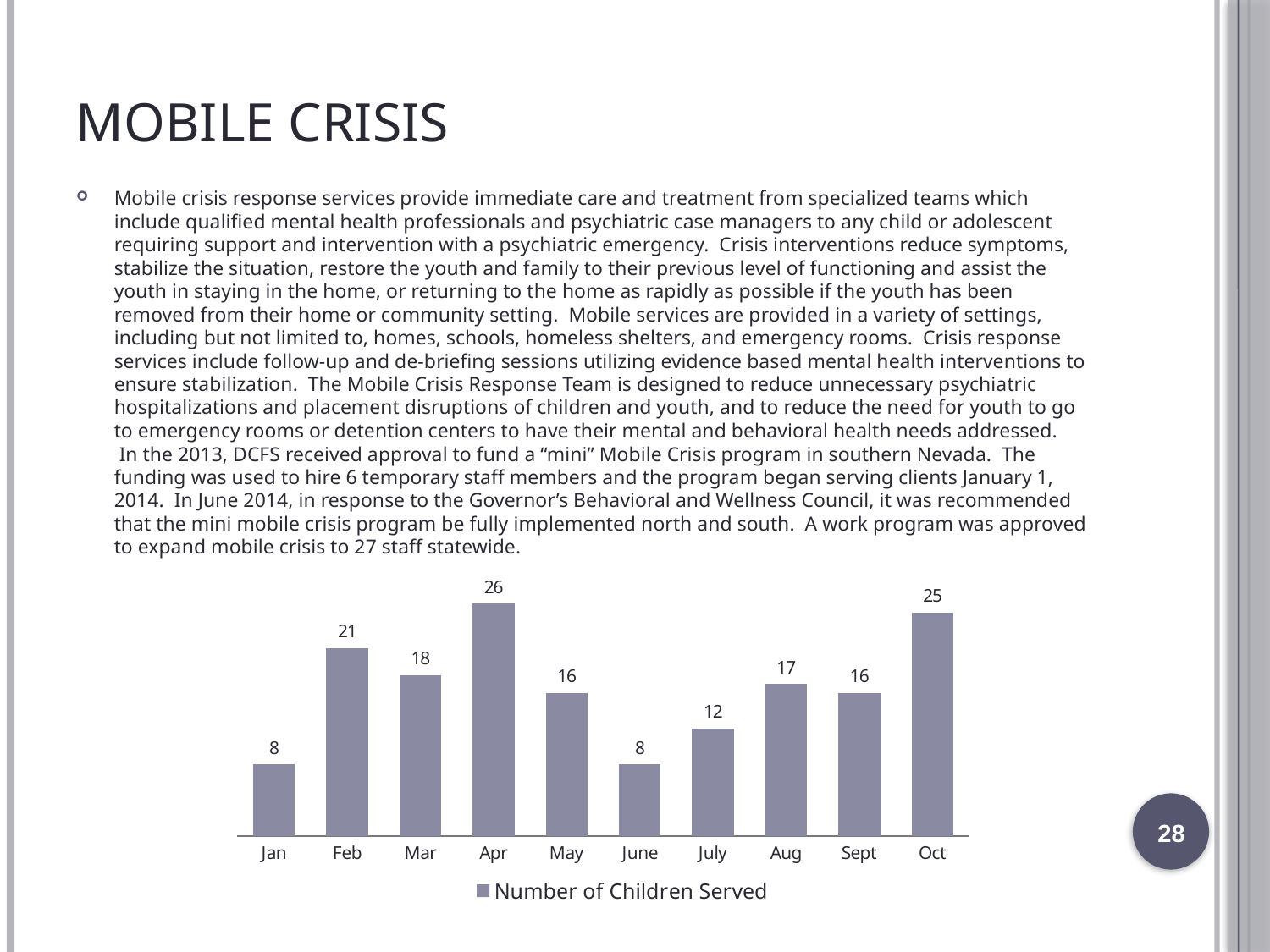
What kind of chart is shown on the slide? Bar chart What is the number of children served in July? 12 What is the difference between the number of children served in February and in March? 3 How many series does the chart legend list? 1 How many months are shown on the x axis of the chart? 10 Which month has more children served, August or September? Aug Which months have the lowest number of children served? Jan and June What is the number of children served in April? 26 What is the difference between the number of children served in April and in June? 18 What is the series name shown in the chart legend? Number of Children Served What is the number of children served in October? 25 Which month has the highest number of children served? Apr